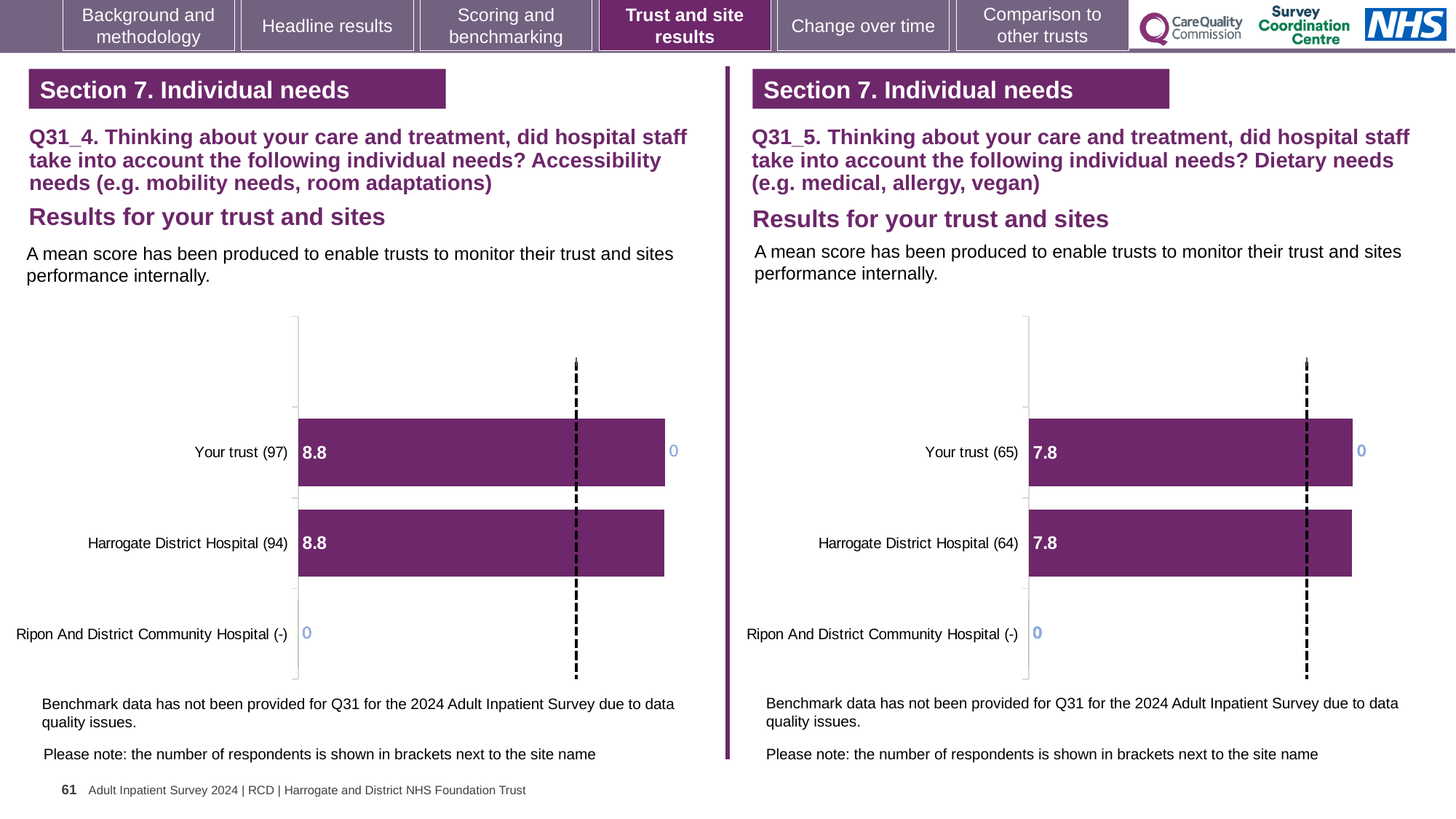
On the left chart (Q31_4, accessibility needs), what is the mean score for Harrogate District Hospital? 8.8 What kind of chart is used on the right (Q31_5, dietary needs)? Bar chart On the left chart (Q31_4, accessibility needs), what colour are the bars? Purple On the right chart (Q31_5, dietary needs), how many respondents are shown in brackets for Harrogate District Hospital? 64 On the right chart (Q31_5, dietary needs), which site has no respondent count shown (a dash in brackets)? Ripon And District Community Hospital On the left chart (Q31_4, accessibility needs), is the score for Your trust greater or less than the score for Harrogate District Hospital, or are they equal? Equal On the left chart (Q31_4, accessibility needs), how many respondents are shown in brackets for Your trust? 97 On the left chart (Q31_4, accessibility needs), how many site categories are listed on the vertical axis? 3 On the right chart (Q31_5, dietary needs), what is the mean score for Harrogate District Hospital? 7.8 On the right chart (Q31_5, dietary needs), what is the difference between the scores for Your trust and Harrogate District Hospital? 0 On the left chart (Q31_4, accessibility needs), what is the mean score for Your trust? 8.8 On the right chart (Q31_5, dietary needs), what is the mean score for Your trust? 7.8